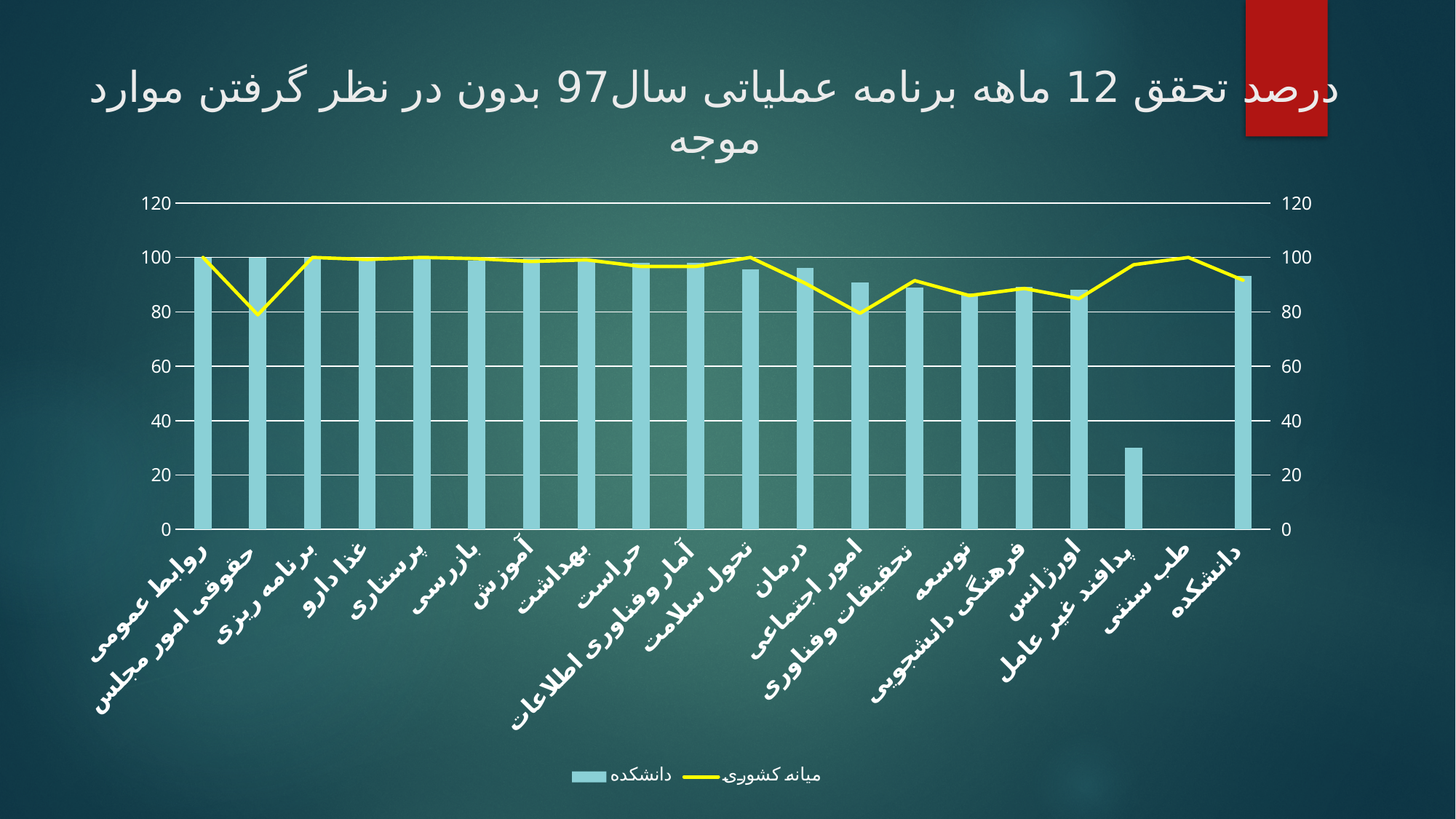
Which has the larger دانشکده value, روابط عمومی or توسعه? روابط عمومی Is the دانشکده value for پدافند غیر عامل greater or less than 40? less Which has the larger دانشکده value, اورژانس or پدافند غیر عامل? اورژانس What kind of chart is shown on the slide? A bar chart combined with a line Is the دانشکده value for درمان greater or less than 80? greater What is the دانشکده bar value for برنامه ریزی? 100 What is the دانشکده bar value for روابط عمومی? 100 How many series does the legend list? 2 What are the two series named in the legend? دانشکده and میانه کشوری Is the دانشکده value for توسعه greater or less than 80? greater What colour is the میانه کشوری line? Yellow How many categories are shown along the x axis? 20